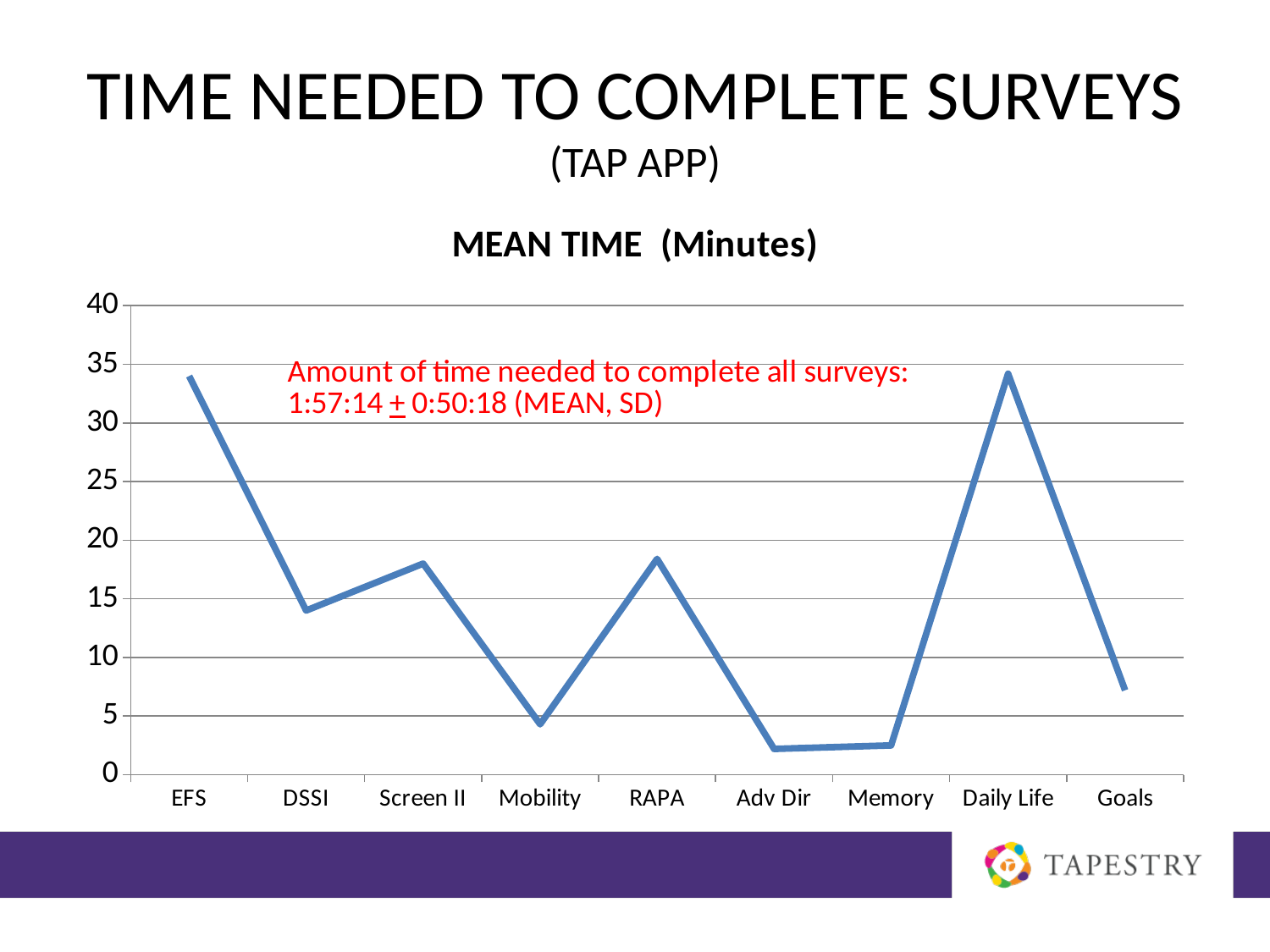
What kind of chart is shown on the slide? line chart Is the mean time for RAPA greater or less than 15 minutes? greater Does the mean time rise or fall from Memory to Daily Life? rise Is the mean time for Mobility greater or less than 5 minutes? less Is the mean time for EFS greater or less than 30 minutes? greater How many surveys are plotted along the x axis of the chart? 9 What is the title of the chart? MEAN TIME (Minutes) Which survey has the higher mean time, EFS or DSSI? EFS Which survey has the higher mean time, RAPA or Mobility? RAPA